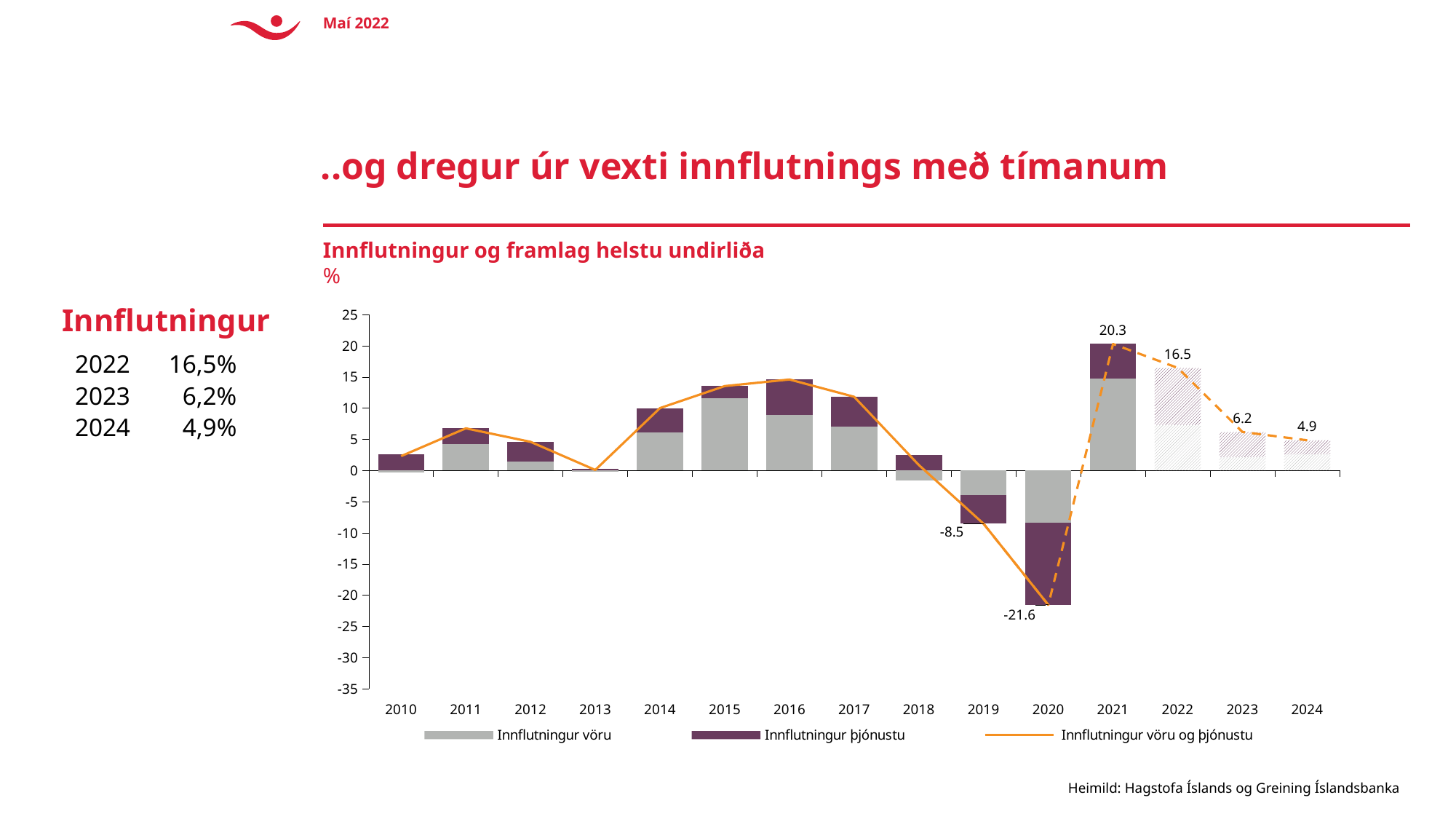
Which year has the larger value of Innflutningur vöru og þjónustu, 2023 or 2024? 2023 What is the value of Innflutningur vöru og þjónustu for 2022? 16.5 What is the difference between the Innflutningur vöru og þjónustu values for 2021 and 2022? 3.8 Is the value of Innflutningur vöru og þjónustu for 2016 greater or less than 10? greater How many series does the chart legend list? 3 What is the value of Innflutningur vöru og þjónustu for 2020? -21.6 Which year has the highest value of Innflutningur vöru og þjónustu? 2021 Do the values of Innflutningur vöru og þjónustu rise or fall from 2021 to 2024? fall What is the value of Innflutningur vöru og þjónustu for 2021? 20.3 Which year has the lowest value of Innflutningur vöru og þjónustu? 2020 How many years are shown on the x axis of the chart? 15 What is the value of Innflutningur vöru og þjónustu for 2019? -8.5